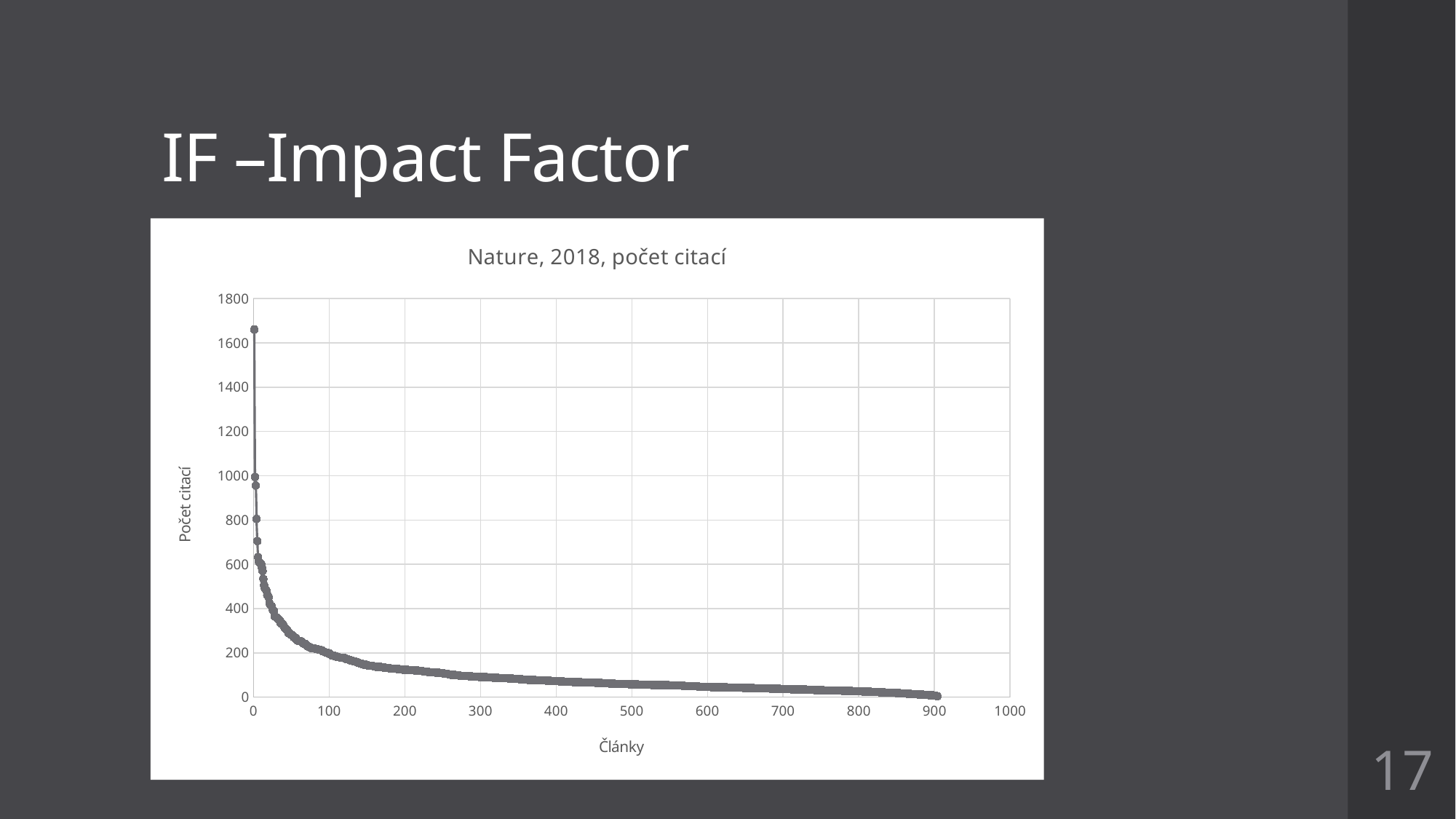
Is the value plotted at around 500 articles greater or less than 200? less What is the highest tick value shown on the y axis? 1800 Is the value plotted at around 900 articles greater or less than 100? less What kind of chart is shown on the slide? scatter chart Is the value plotted at around 100 articles greater or less than 400? less Do the values rise or fall as the number of articles increases along the x axis? fall What is the title of the chart? Nature, 2018, počet citací Which is larger: the value plotted at around 100 articles or the value plotted at around 800 articles? the value at around 100 articles What is the label of the x axis? Články